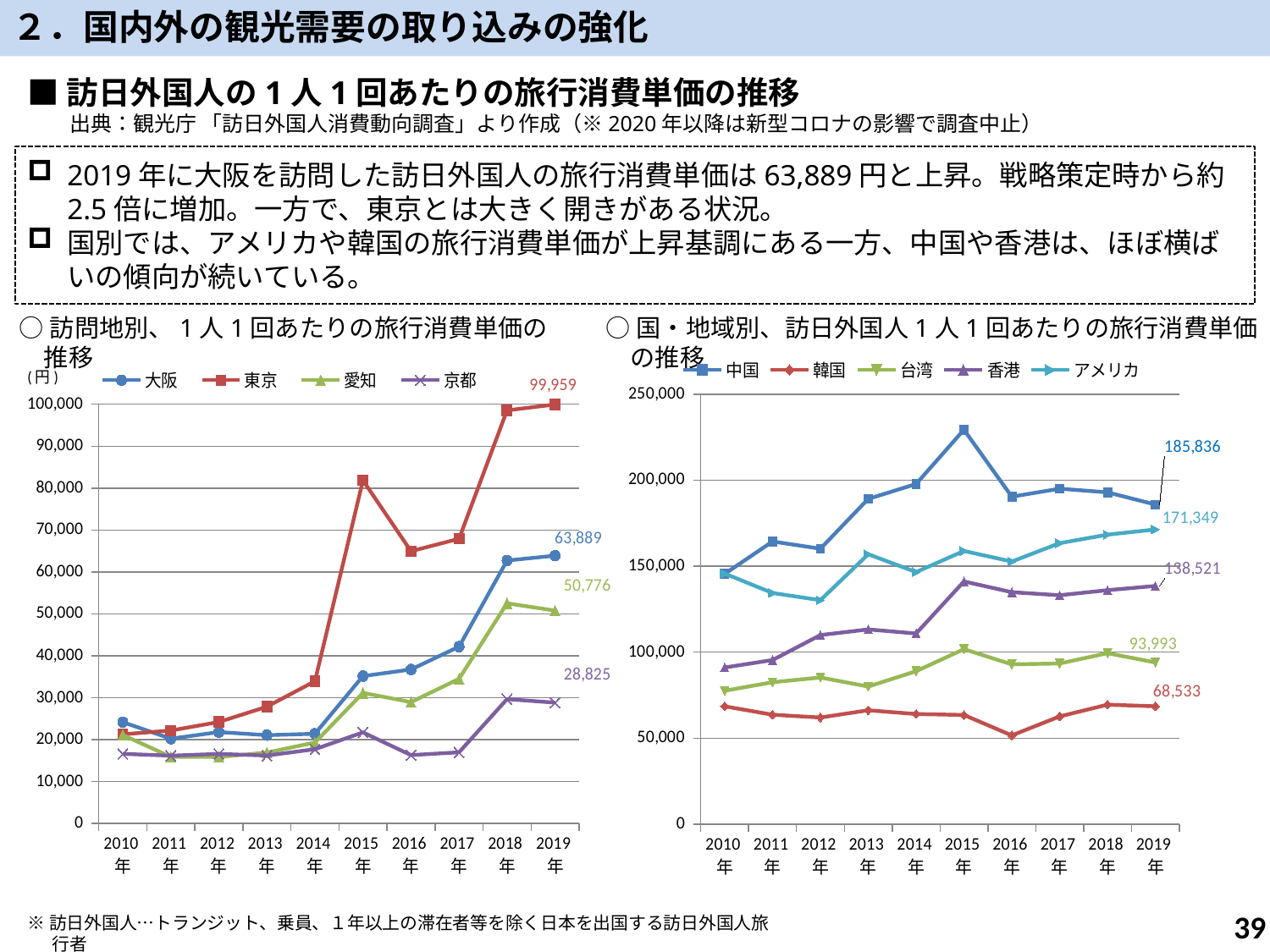
What type of chart is the left chart (訪問地別)? line chart In the right chart (国・地域別), is the 2019 value for 台湾 greater or less than the 2019 value for 香港? less In the right chart (国・地域別), is the value for 中国 in 2015 greater or less than 200,000? greater How many series does the legend of the right chart (国・地域別) list? 5 In the left chart (訪問地別), what is the 2019 value for 大阪? 63,889 In the left chart (訪問地別), what is the difference between the 2019 values for 東京 and 大阪? 36,070 In the right chart (国・地域別), what is the difference between the 2019 values for 中国 and 香港? 47,315 In the left chart (訪問地別), which series has the highest value in 2019? 東京 In the right chart (国・地域別), what is the 2019 value for アメリカ? 171,349 In the left chart (訪問地別), what is the 2019 value for 東京? 99,959 In the right chart (国・地域別), which series has the lowest value in 2019? 韓国 In the right chart (国・地域別), what is the 2019 value for 韓国? 68,533